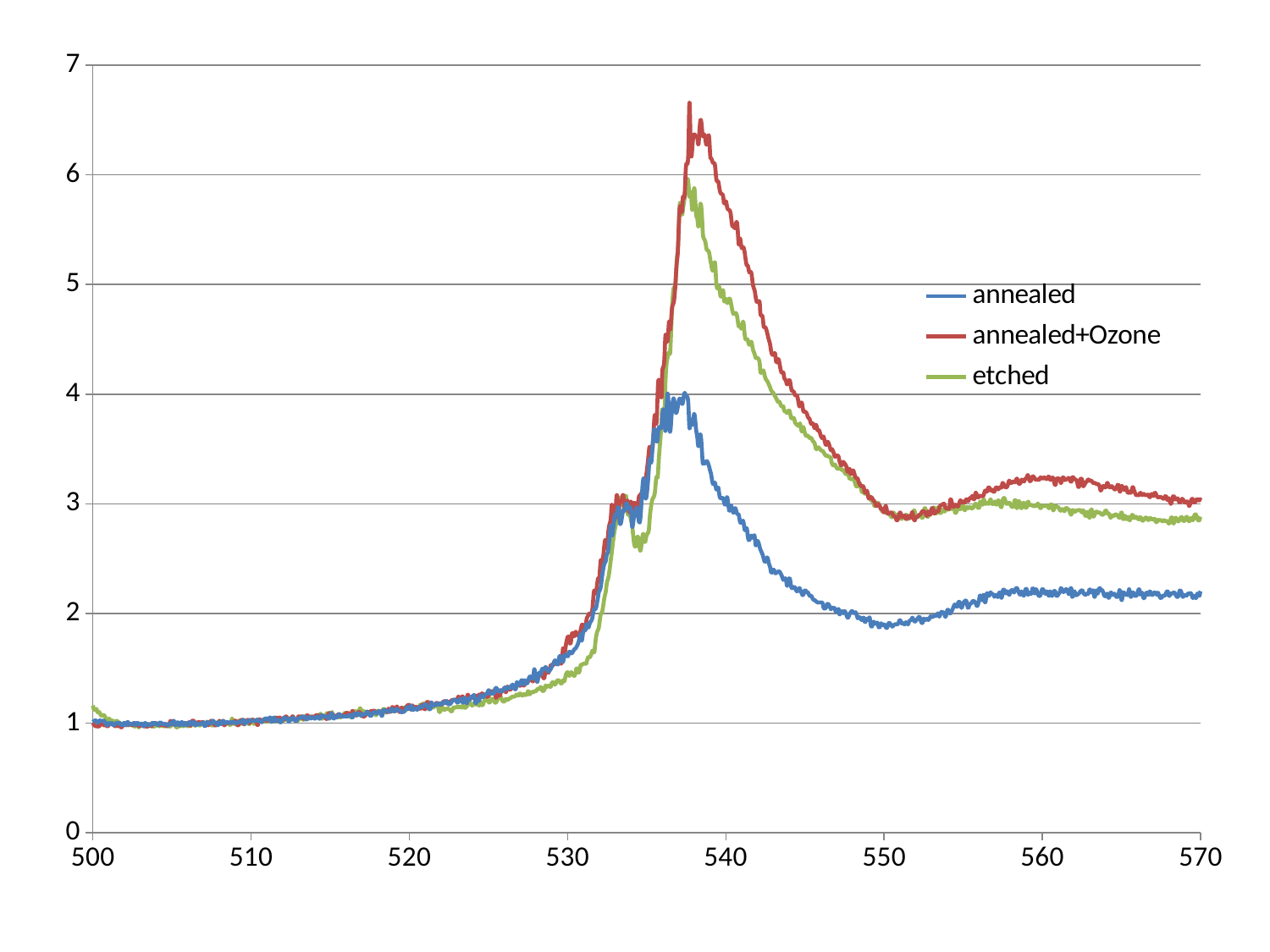
Is the peak value of the etched series greater or less than 5? greater Is the peak value of the annealed+Ozone series greater or less than 6? greater At 560 on the x axis, which series is higher: annealed or annealed+Ozone? annealed+Ozone How many series does the legend list? 3 Which series has the lowest peak value? annealed What kind of chart is shown on the slide? line chart What colour is the line for the etched series? green Between 540 and 550 on the x axis, do the values of the annealed+Ozone series rise or fall? fall Is the peak value of the annealed series greater or less than 5? less Which series reaches the highest peak value? annealed+Ozone Between 530 and 537 on the x axis, do the values of the annealed series rise or fall? rise